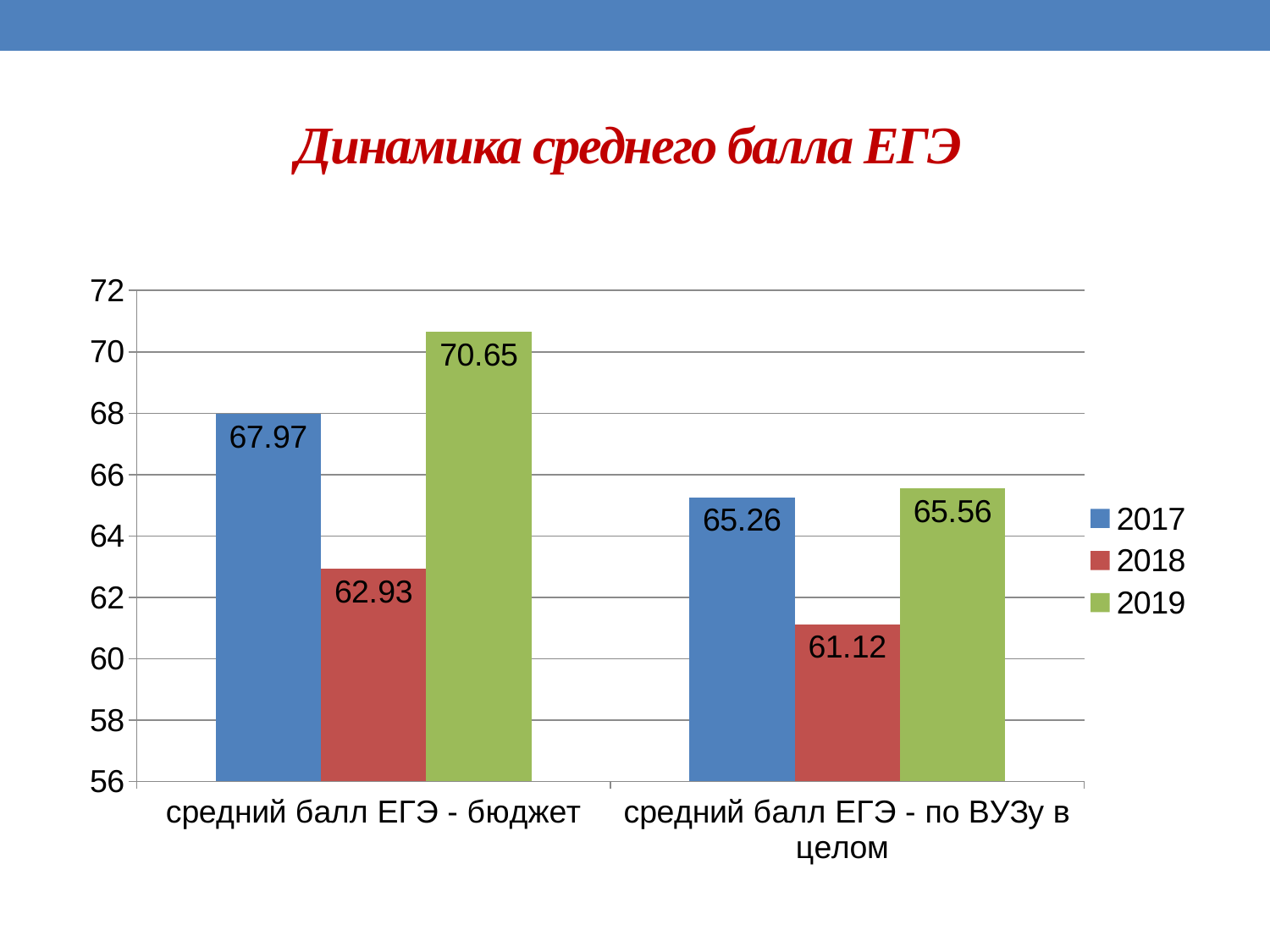
What is the value for 2018 in the category "средний балл ЕГЭ - по ВУЗу в целом"? 61.12 What is the difference between the 2019 and 2018 values in the category "средний балл ЕГЭ - бюджет"? 7.72 What kind of chart is shown on the slide? bar chart Which is larger: the 2017 value for "средний балл ЕГЭ - бюджет" or the 2017 value for "средний балл ЕГЭ - по ВУЗу в целом"? средний балл ЕГЭ - бюджет Is the 2018 value for "средний балл ЕГЭ - по ВУЗу в целом" greater or less than 62? less What is the value for 2019 in the category "средний балл ЕГЭ - бюджет"? 70.65 Which year has the highest value in the category "средний балл ЕГЭ - по ВУЗу в целом"? 2019 What is the title of the slide? Динамика среднего балла ЕГЭ What is the value for 2017 in the category "средний балл ЕГЭ - бюджет"? 67.97 How many series does the legend list? 3 Which year has the lowest value in the category "средний балл ЕГЭ - бюджет"? 2018 What is the difference between the 2017 and 2018 values in the category "средний балл ЕГЭ - по ВУЗу в целом"? 4.14